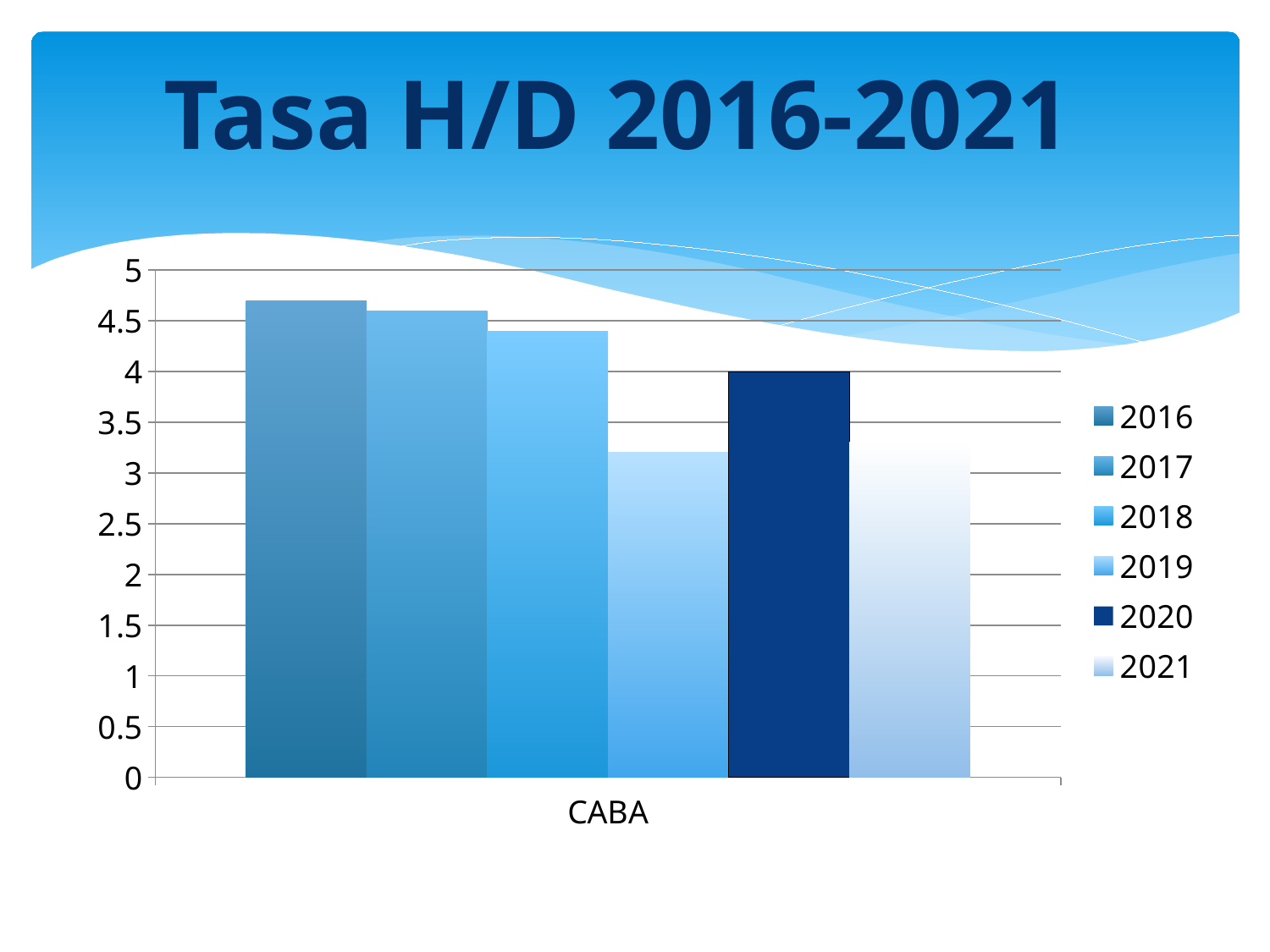
What kind of chart is shown on the slide? bar chart What is the title of the slide's chart? Tasa H/D 2016-2021 Which is larger, the value for 2016 or the value for 2019? 2016 Is the value for 2018 greater or less than 4.5? less Is the value for 2016 greater or less than 4.5? greater How many series does the legend list? 6 What is the value for 2020 for CABA? 4 Which is larger, the value for 2018 or the value for 2020? 2018 Is the value for 2021 greater or less than 3.5? less Which year has the highest value for CABA? 2016 What is the category label shown on the x axis? CABA